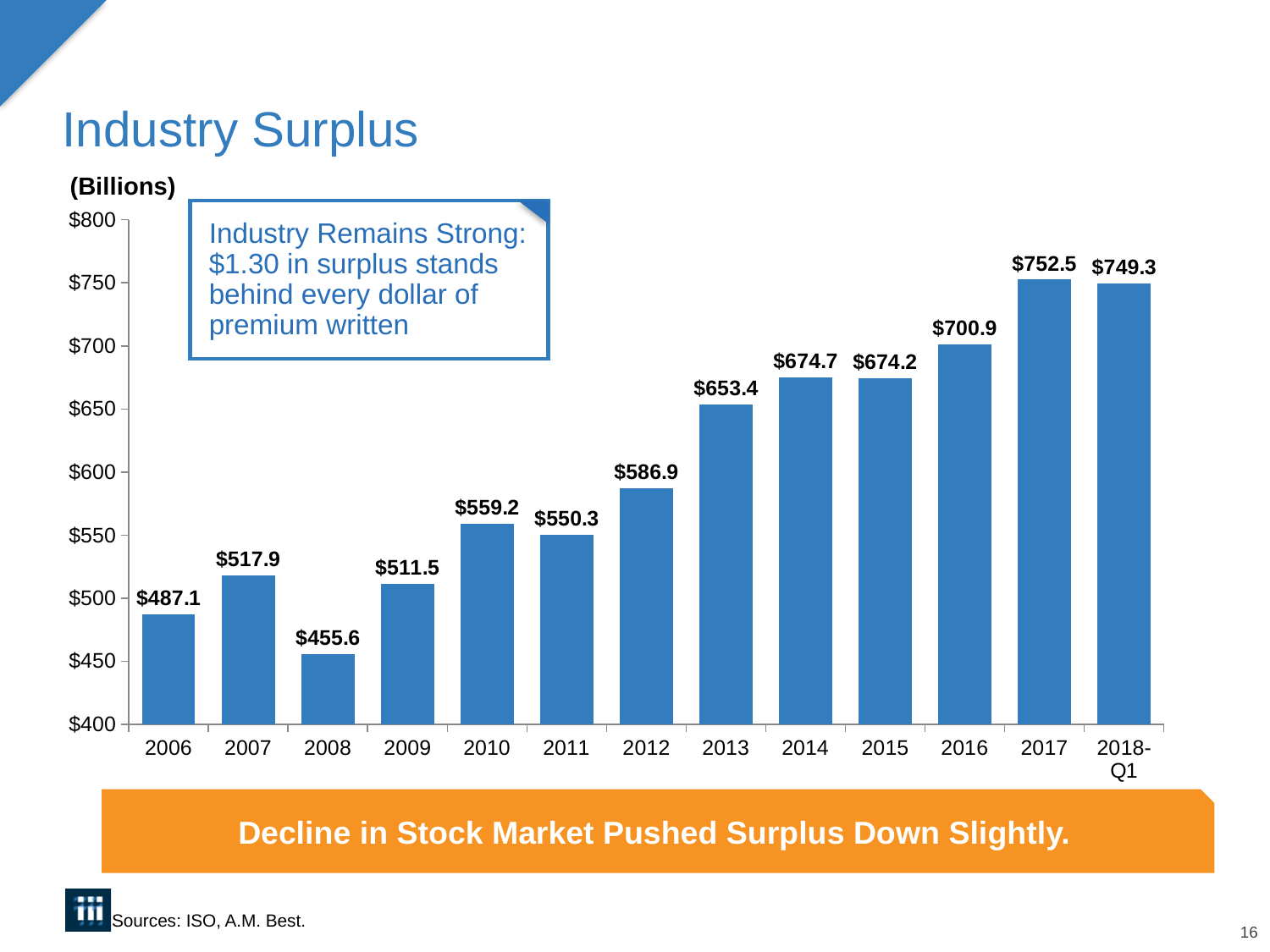
Which is larger, the industry surplus in 2010 or in 2011? 2010 What is the difference between the industry surplus in 2016 and 2015? $26.7 Which year has the highest industry surplus? 2017 How many bars are shown in the chart? 13 What is the industry surplus value for 2017? $752.5 What is the industry surplus value for 2008? $455.6 Which year has the lowest industry surplus? 2008 What is the industry surplus value for 2018-Q1? $749.3 Is the industry surplus for 2013 greater or less than $650? greater What type of chart is shown on the slide? Bar chart What unit is indicated for the values in the chart? Billions What is the difference between the industry surplus in 2017 and 2018-Q1? $3.2